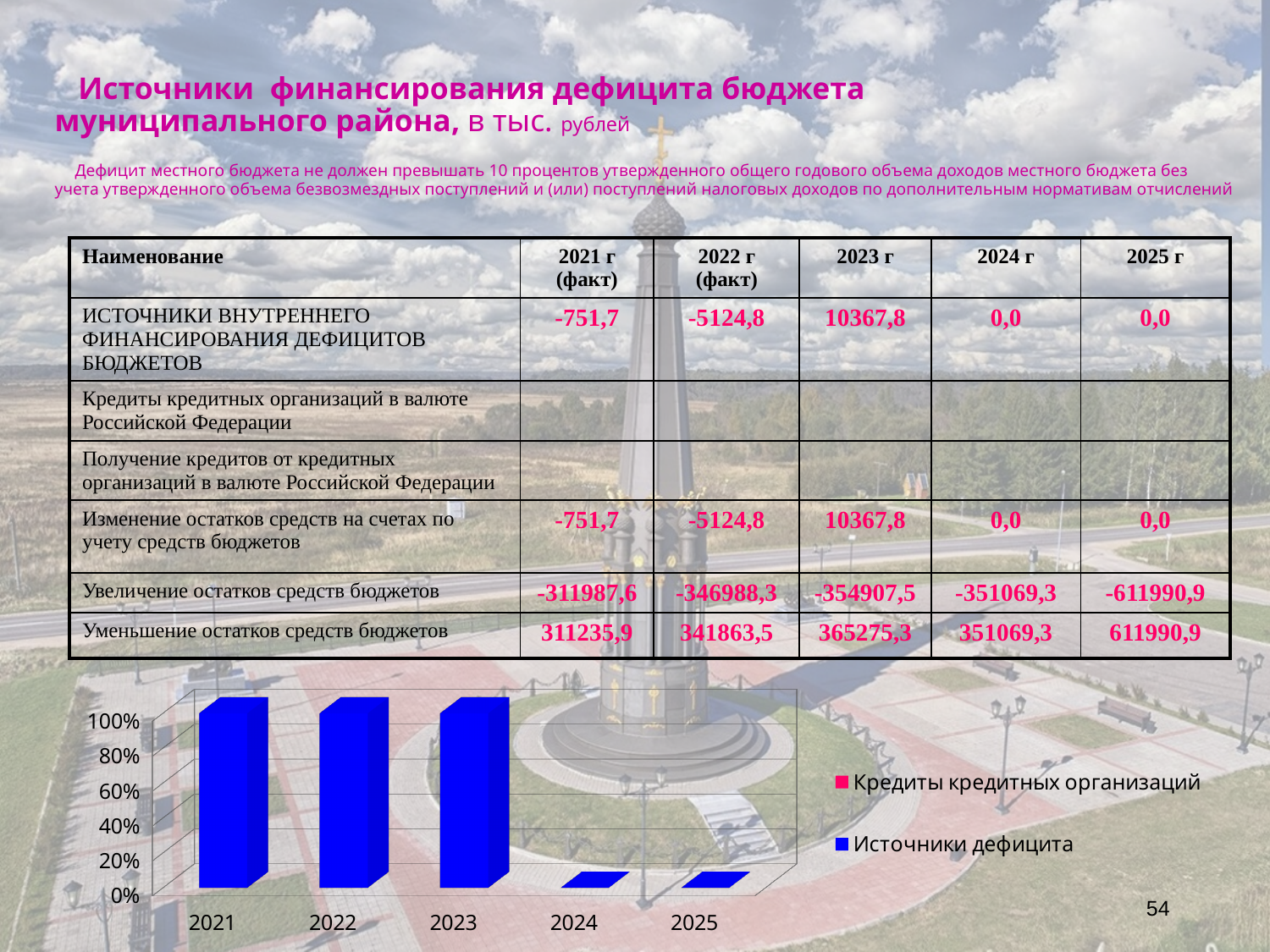
Which colour represents the series "Источники дефицита" in the bar chart? blue In the bar chart, is the value for 2025 greater or less than 20%? less What are the two series named in the legend of the bar chart? Кредиты кредитных организаций; Источники дефицита What is the first year shown on the x axis of the bar chart? 2021 How many series does the legend of the bar chart list? 2 In the bar chart, is the value for 2021 greater or less than 80%? greater In the bar chart, is the value for 2024 greater or less than 20%? less In the bar chart, which is larger, the bar for 2022 or the bar for 2024? 2022 How many years are shown on the x axis of the bar chart? 5 What kind of chart is shown at the bottom of the slide? bar chart In the bar chart, which is larger, the bar for 2023 or the bar for 2025? 2023